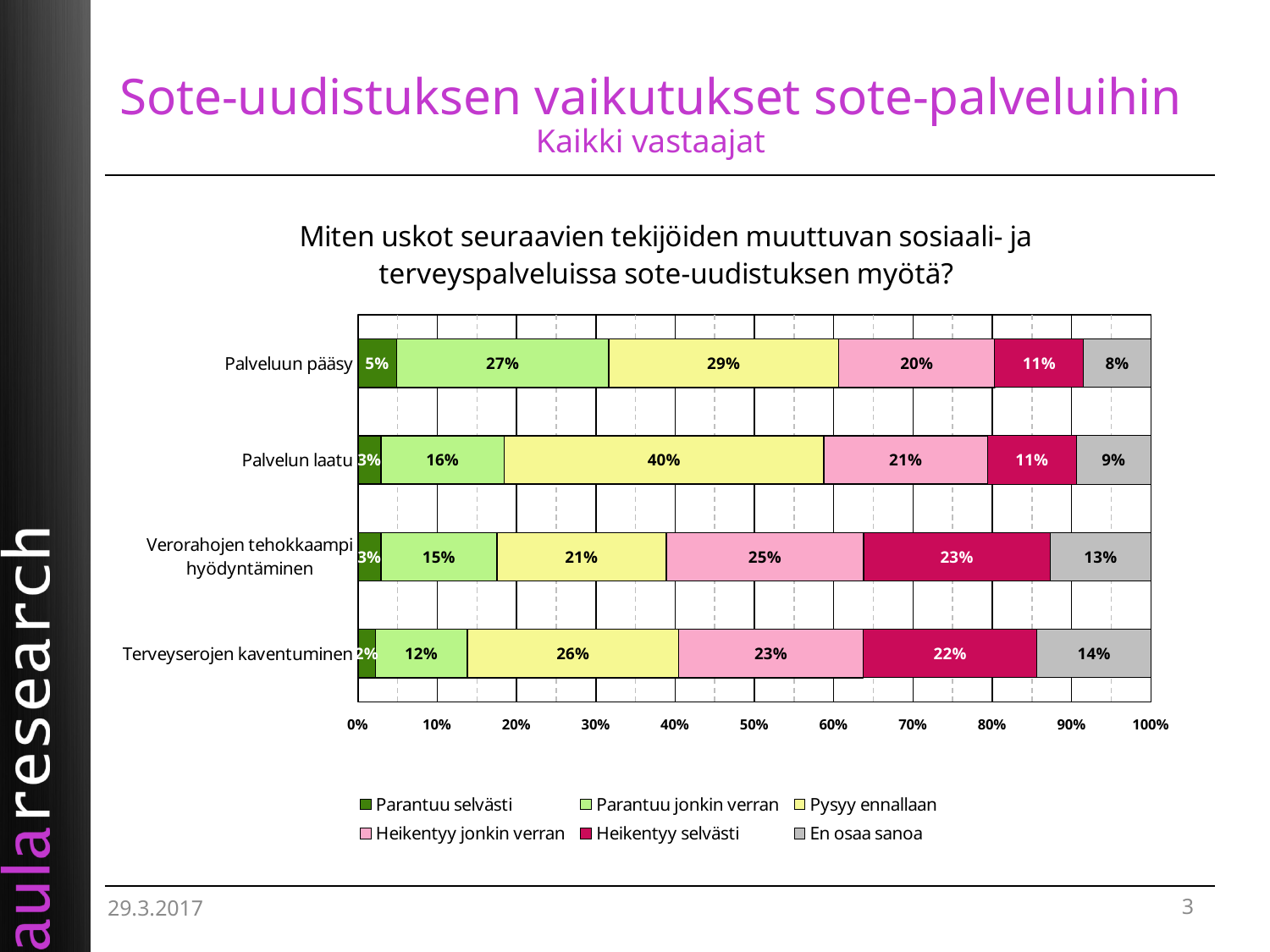
What is the value of 'En osaa sanoa' for 'Terveyserojen kaventuminen'? 14% What kind of chart is shown on the slide? Stacked bar chart What is the value of 'Parantuu jonkin verran' for 'Palveluun pääsy'? 27% Which is larger: 'Heikentyy selvästi' for 'Palvelun laatu' or for 'Terveyserojen kaventuminen'? Terveyserojen kaventuminen What is the value of 'Heikentyy selvästi' for 'Verorahojen tehokkaampi hyödyntäminen'? 23% Which category has the highest value for 'Pysyy ennallaan'? Palvelun laatu How many categories are plotted on the chart? 4 Which legend entry is shown in dark green? Parantuu selvästi Which category has the lowest value for 'Parantuu selvästi'? Terveyserojen kaventuminen What is the value of 'Pysyy ennallaan' for 'Palvelun laatu'? 40% What is the difference between the 'Heikentyy jonkin verran' values for 'Verorahojen tehokkaampi hyödyntäminen' and 'Palveluun pääsy'? 5% How many series does the legend list? 6